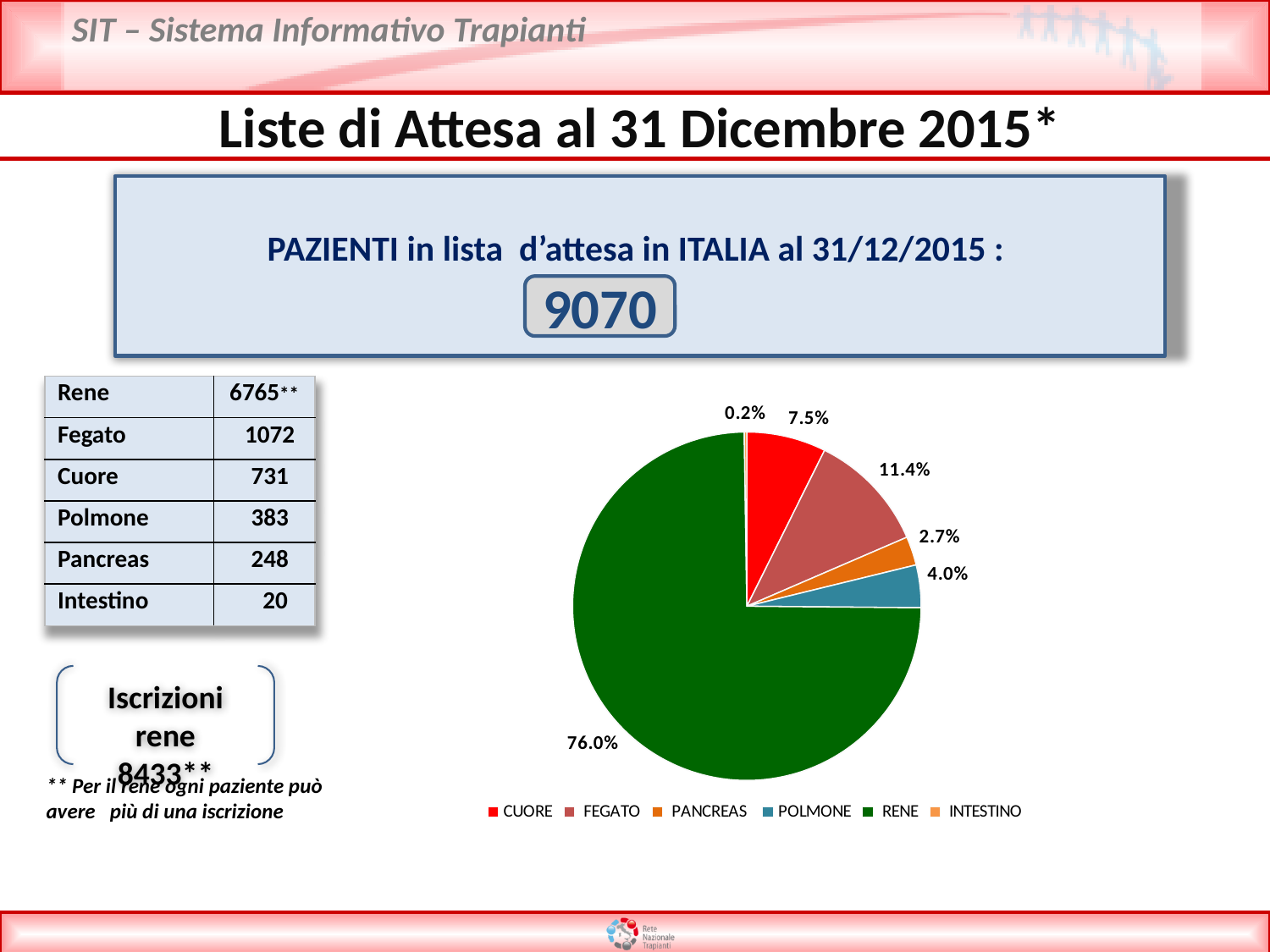
What share of the pie chart does PANCREAS represent? 2.7% Which category has the largest slice in the pie chart? RENE Which category has the smallest slice in the pie chart? INTESTINO How many entries does the pie chart legend list? 6 How many slices does the pie chart have? 6 What share of the pie chart does FEGATO represent? 11.4% What share of the pie chart does RENE represent? 76.0% What kind of chart is shown on the slide? pie chart In the pie chart, which is larger, the share for FEGATO or the share for CUORE? FEGATO What is the difference in percentage points between the FEGATO slice and the CUORE slice in the pie chart? 3.9%